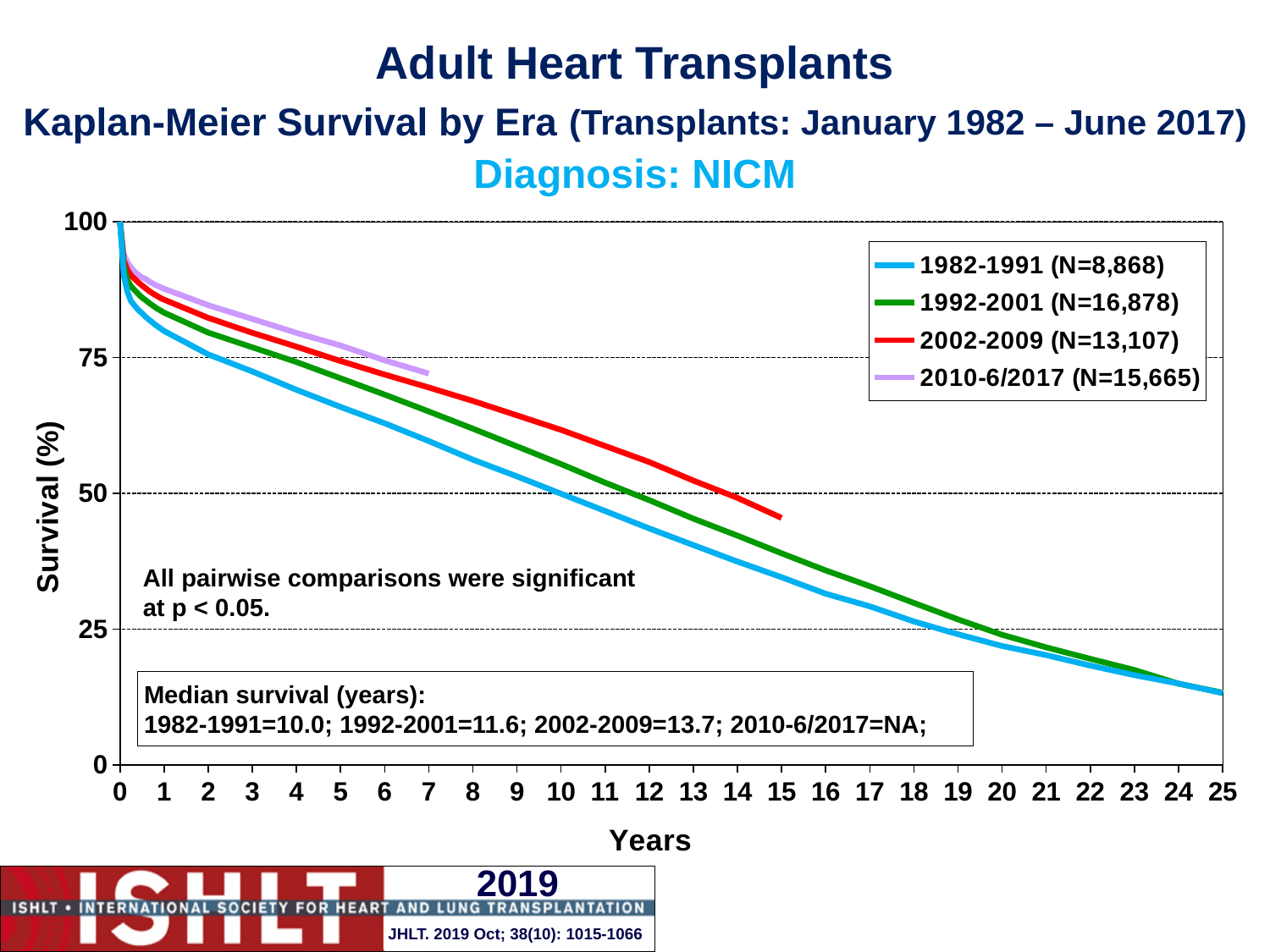
How many series does the legend list? 4 Do the survival curves rise or fall as years increase? fall What kind of chart is shown on the slide? line chart Is the survival value for the 2002-2009 era at 15 years greater or less than 50? less What is the N for the 1992-2001 era shown in the legend? 16,878 What is the median survival in years for the 1992-2001 era? 11.6 Which era has the highest survival at 5 years? 2010-6/2017 What is the median survival in years for the 2002-2009 era? 13.7 Is the survival value for the 1992-2001 era at 25 years greater or less than 25? less At 10 years, which era has higher survival: 2002-2009 or 1982-1991? 2002-2009 Is the survival value for the 1982-1991 era at 5 years greater or less than 50? greater What is the median survival in years for the 1982-1991 era? 10.0